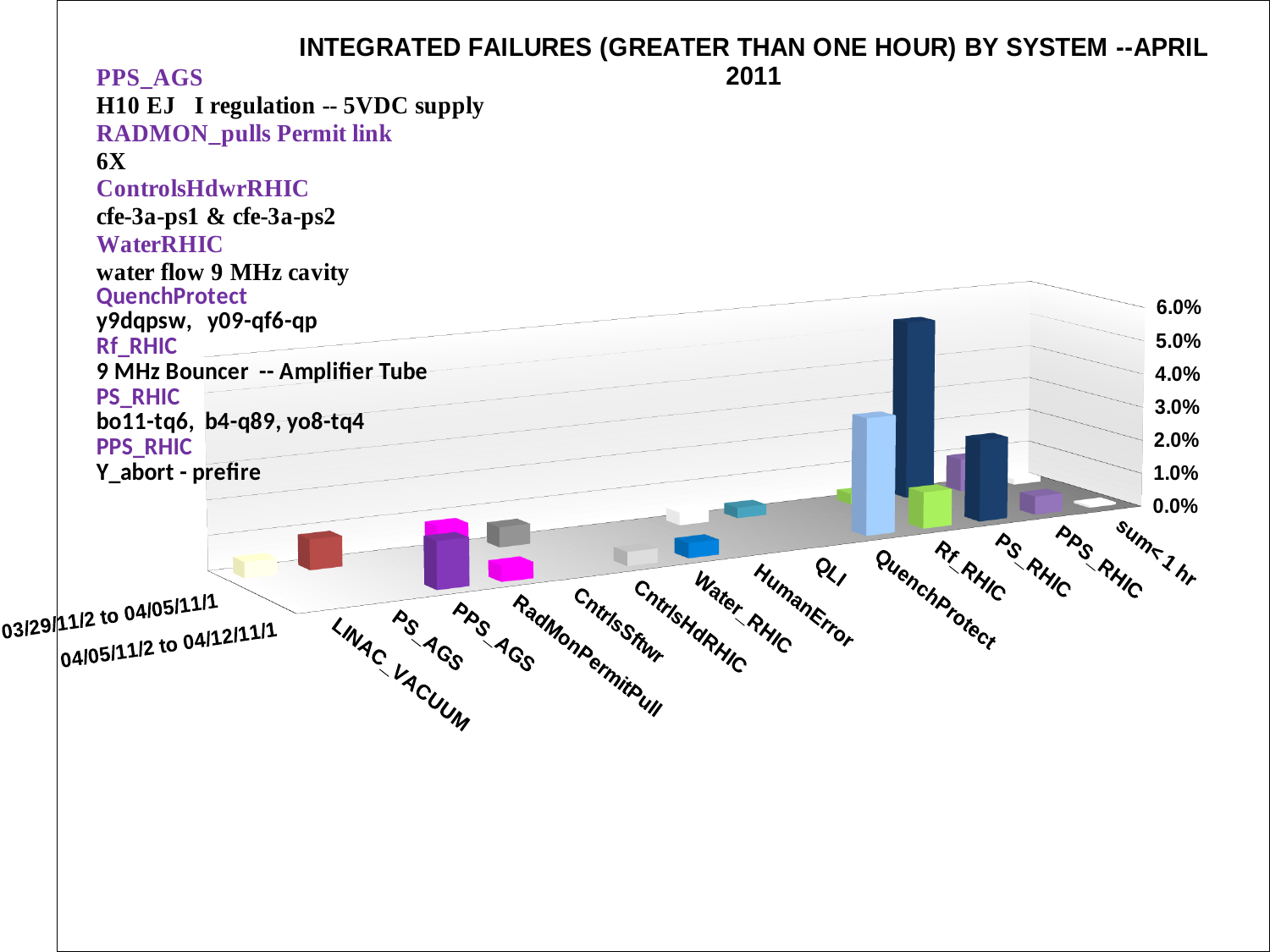
How many data series (date ranges) are plotted in the chart? 2 What is the title of the chart? INTEGRATED FAILURES (GREATER THAN ONE HOUR) BY SYSTEM --APRIL 2011 Which system category has the tallest bar in the chart? PS_RHIC Is the value for Rf_RHIC in the 03/29/11/2 to 04/05/11/1 series greater or less than 1.0%? less In the 04/05/11/2 to 04/12/11/1 series, which is larger: QuenchProtect or Rf_RHIC? QuenchProtect What kind of chart is shown on the slide? bar chart Which has the larger value: QuenchProtect or LINAC_VACUUM? QuenchProtect What is the highest value shown on the vertical axis of the chart? 6.0% How many system categories are shown along the x axis of the chart? 14